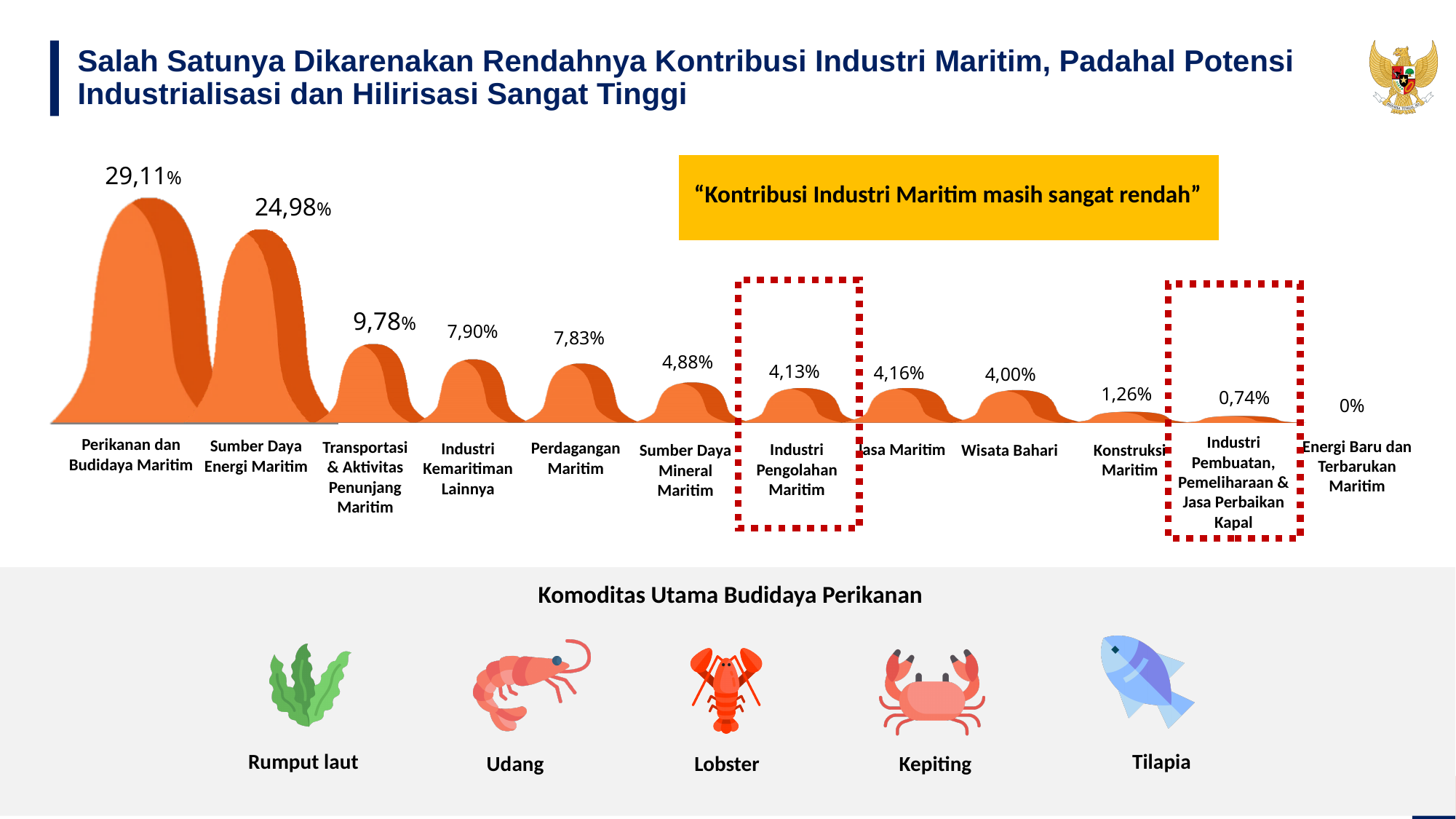
What does the yellow box on the chart say? "Kontribusi Industri Maritim masih sangat rendah" What is the value for Perikanan dan Budidaya Maritim? 29,11% What kind of chart is this? Area chart What is the value for Industri Pengolahan Maritim? 4,13% What is the value for Konstruksi Maritim? 1,26% Which is larger, the value for Transportasi & Aktivitas Penunjang Maritim or the value for Industri Kemaritiman Lainnya? Transportasi & Aktivitas Penunjang Maritim Which category has the highest value? Perikanan dan Budidaya Maritim How many categories are shown in the chart? 12 Do the values generally rise or fall from left to right along the x axis? Fall What is the difference between the values for Perikanan dan Budidaya Maritim and Sumber Daya Energi Maritim? 4,13% Which category has the lowest value? Energi Baru dan Terbarukan Maritim What is the value for Industri Pembuatan, Pemeliharaan & Jasa Perbaikan Kapal? 0,74%